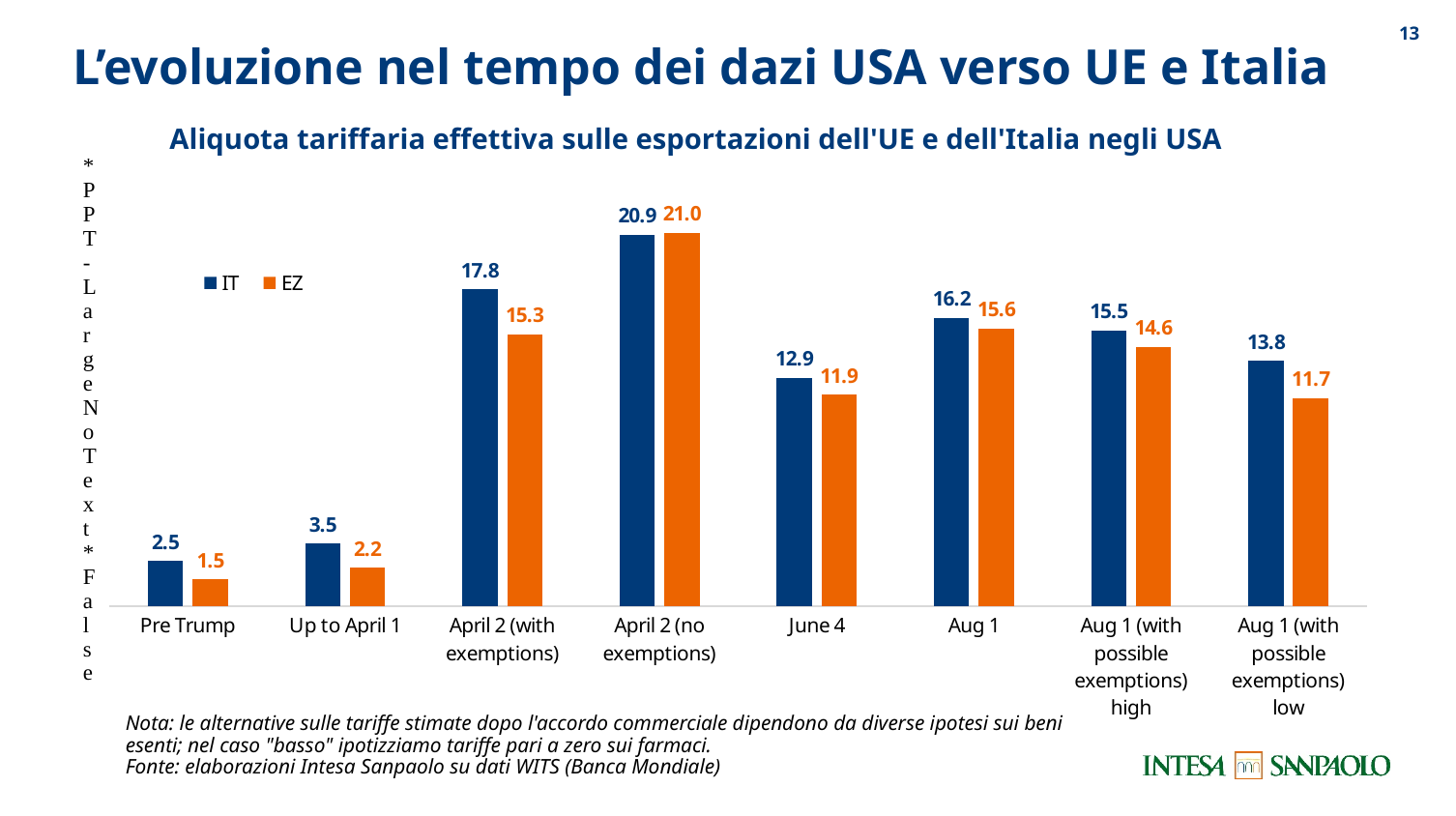
What is the EZ value for Pre Trump? 1.5 Which category has the highest EZ value? April 2 (no exemptions) Which is larger for Up to April 1, the IT value or the EZ value? IT How many series does the legend list? 2 What kind of chart is shown on the slide? Bar chart What is the title of the chart? Aliquota tariffaria effettiva sulle esportazioni dell'UE e dell'Italia negli USA What is the IT value for Aug 1 (with possible exemptions) low? 13.8 What is the EZ value for June 4? 11.9 Which category has the lowest IT value? Pre Trump What is the difference between the IT and EZ values for Aug 1 (with possible exemptions) low? 2.1 How many categories are shown on the x axis? 8 What is the IT value for April 2 (with exemptions)? 17.8